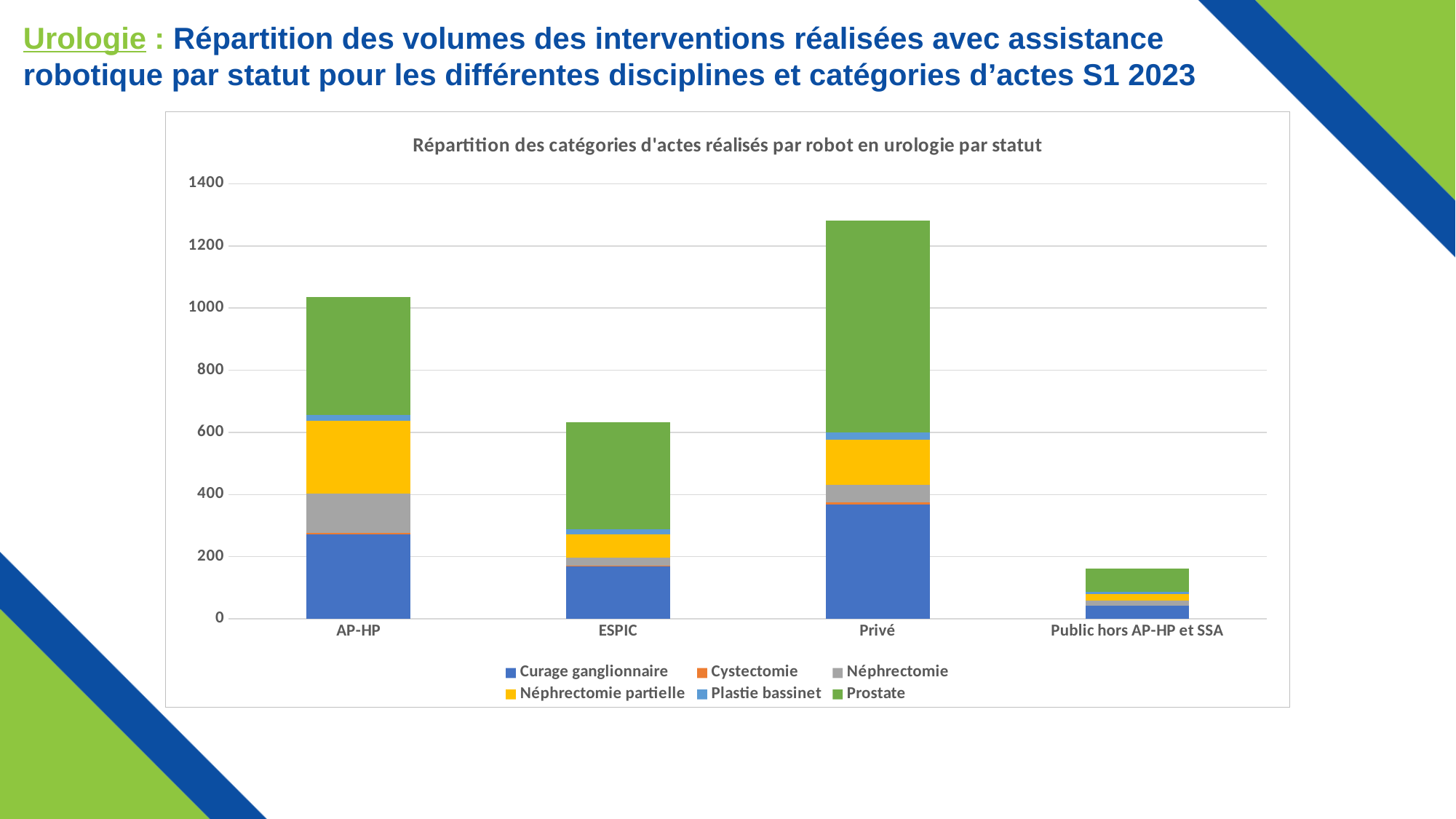
What kind of chart is shown on the slide? Stacked bar chart What is the title of the chart? Répartition des catégories d'actes réalisés par robot en urologie par statut How many status categories are shown on the x axis of the chart? 4 Which status has the tallest stacked bar in the chart? Privé Which status has the shortest stacked bar in the chart? Public hors AP-HP et SSA Which stacked bar is taller, AP-HP or ESPIC? AP-HP Is the total height of the AP-HP bar greater or less than 1000? greater How many series does the chart legend list? 6 Is the total height of the Public hors AP-HP et SSA bar greater or less than 200? less Which colour represents the Prostate series in the chart legend? Green Is the total height of the Privé bar greater or less than 1200? greater Which stacked bar is taller, Privé or AP-HP? Privé